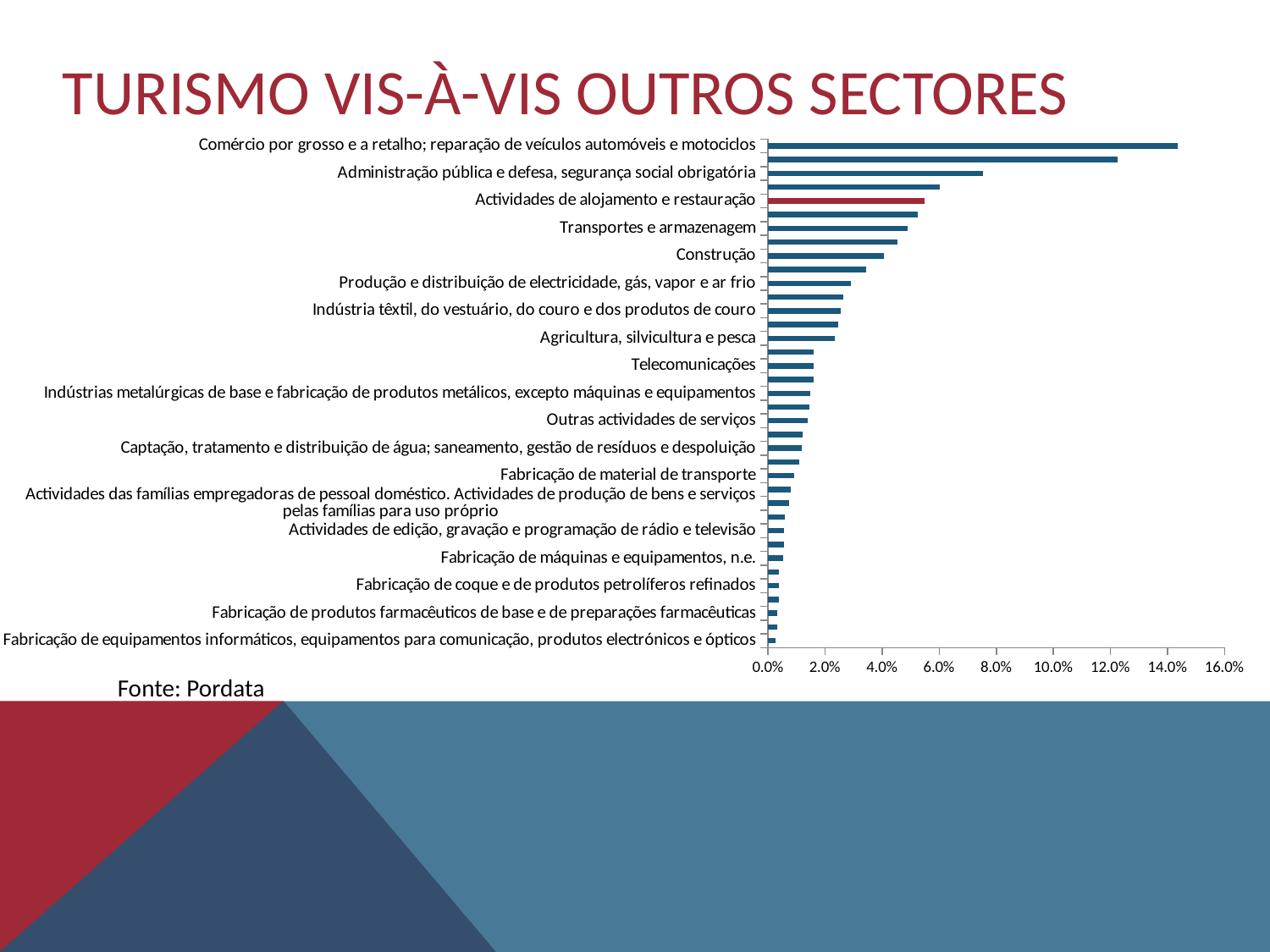
Is the value for Agricultura, silvicultura e pesca greater or less than 2.0%? greater Is the value for Comércio por grosso e a retalho; reparação de veículos automóveis e motociclos greater or less than 14.0%? greater Do the bar values increase or decrease from the top of the chart to the bottom? Decrease Which has a larger value: Actividades de alojamento e restauração or Construção? Actividades de alojamento e restauração Which has a larger value: Telecomunicações or Administração pública e defesa, segurança social obrigatória? Administração pública e defesa, segurança social obrigatória Is the value for Construção greater or less than 6.0%? less What kind of chart is shown on the slide? Bar chart Which category has the highest value in the chart? Comércio por grosso e a retalho; reparação de veículos automóveis e motociclos Which category is highlighted with a red bar instead of a blue one? Actividades de alojamento e restauração Which labelled category has the lowest value in the chart? Fabricação de equipamentos informáticos, equipamentos para comunicação, produtos electrónicos e ópticos